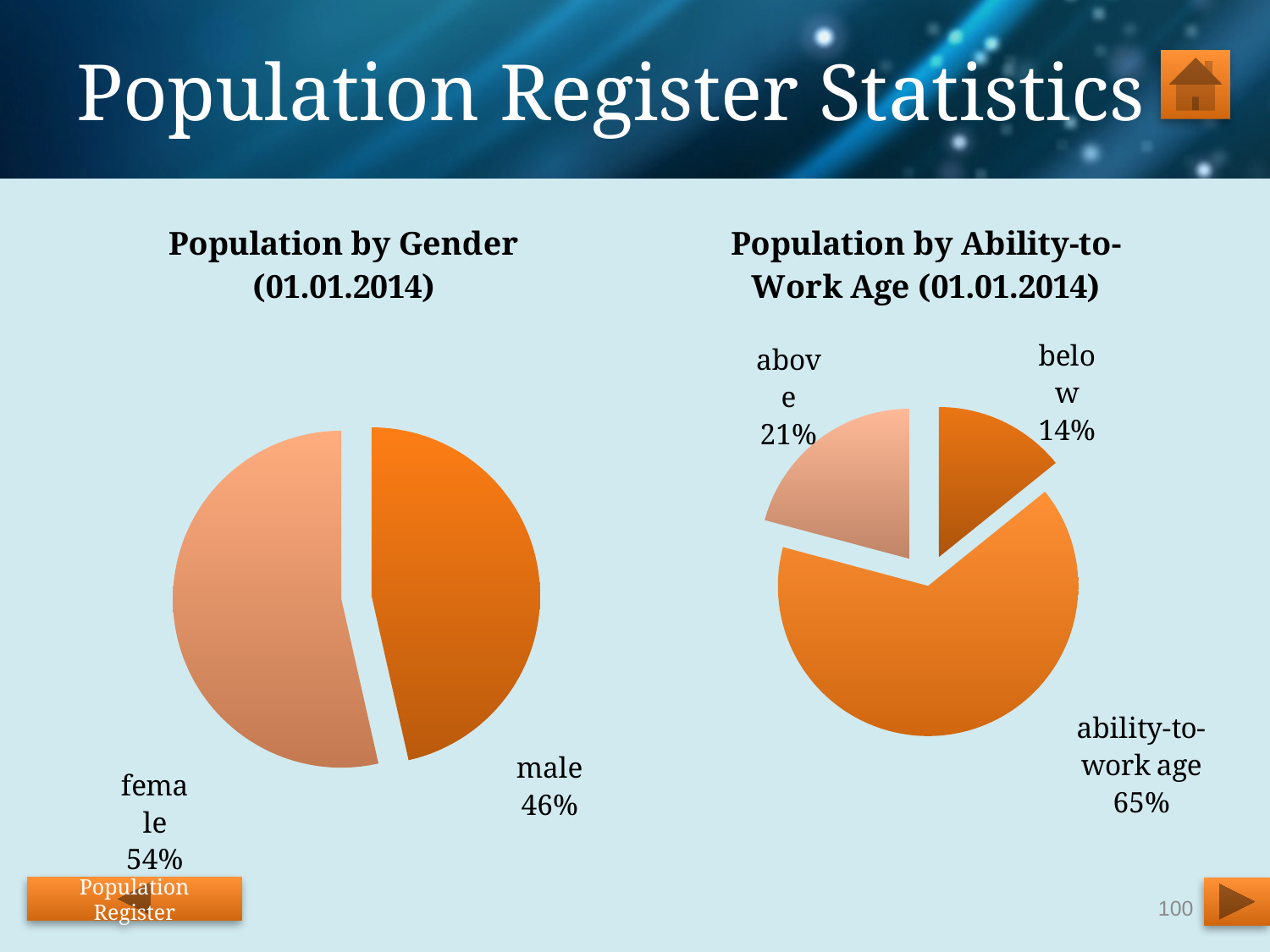
In the 'Population by Ability-to-Work Age (01.01.2014)' chart, what is the difference in percentage points between the 'above' and 'below' shares? 7 In the 'Population by Ability-to-Work Age (01.01.2014)' chart, what share of the population is above ability-to-work age? 21% In the 'Population by Gender (01.01.2014)' chart, what is the difference in percentage points between the female and male shares? 8 In the 'Population by Ability-to-Work Age (01.01.2014)' chart, which category has the largest share? ability-to-work age In the 'Population by Gender (01.01.2014)' chart, what share of the population is male? 46% In the 'Population by Ability-to-Work Age (01.01.2014)' chart, which category has the smallest share? below In the 'Population by Ability-to-Work Age (01.01.2014)' chart, what share of the population is below ability-to-work age? 14% In the 'Population by Ability-to-Work Age (01.01.2014)' chart, how many slices does the pie have? 3 In the 'Population by Ability-to-Work Age (01.01.2014)' chart, what share of the population is of ability-to-work age? 65% What kind of chart is 'Population by Gender (01.01.2014)'? pie chart In the 'Population by Gender (01.01.2014)' chart, which slice is larger, female or male? female In the 'Population by Gender (01.01.2014)' chart, what share of the population is female? 54%